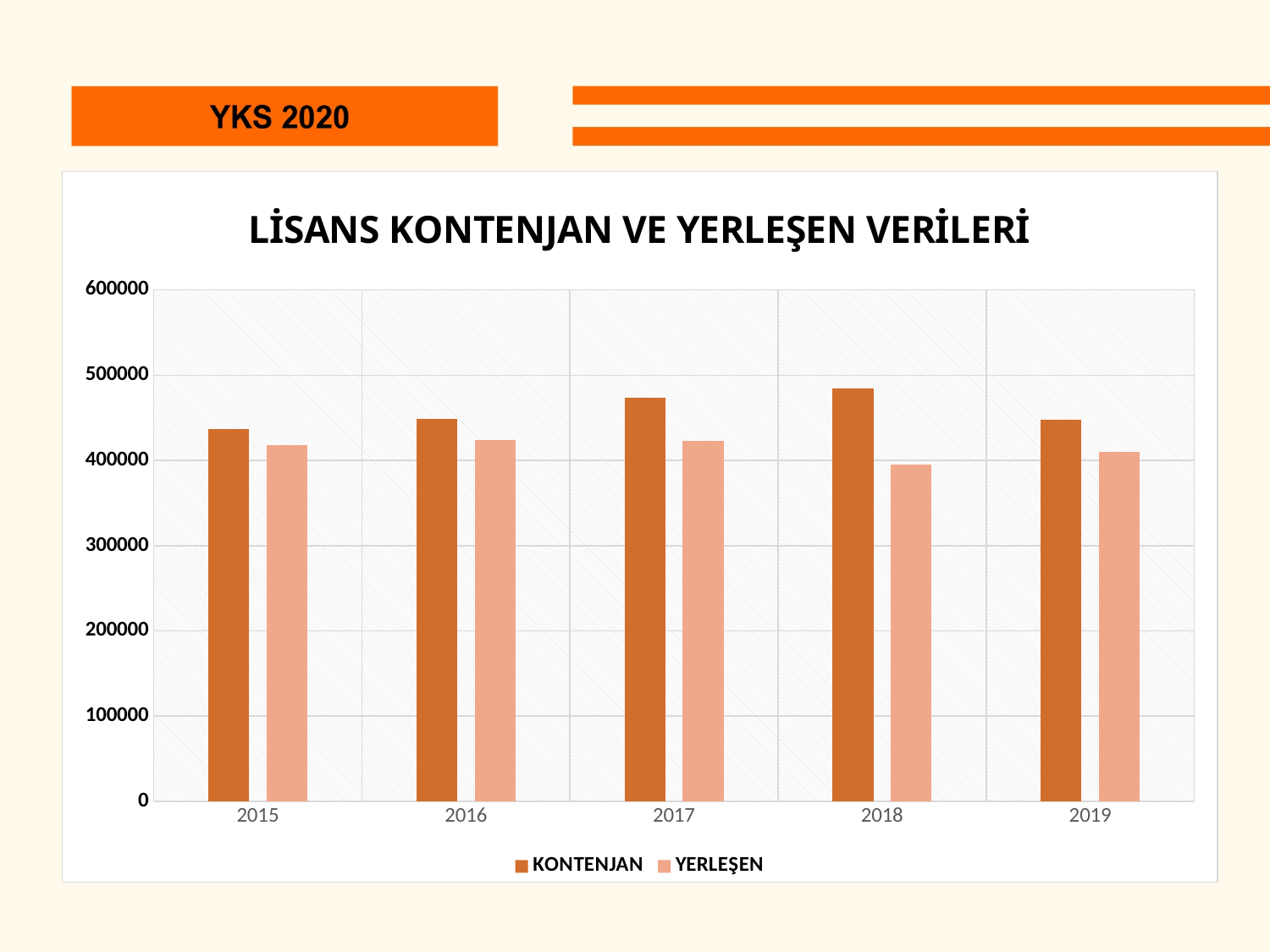
How many series does the legend list? 2 In 2018, which is larger, KONTENJAN or YERLEŞEN? KONTENJAN What is the title of the chart? LİSANS KONTENJAN VE YERLEŞEN VERİLERİ Which year has the highest KONTENJAN value? 2018 Which year has the lowest YERLEŞEN value? 2018 What kind of chart is shown on the slide? bar chart Which is larger, the YERLEŞEN value for 2016 or for 2018? 2016 Does the KONTENJAN value rise or fall from 2015 to 2018? rise Is the YERLEŞEN value for 2015 greater or less than 400000? greater How many years are shown on the x axis? 5 Is the KONTENJAN value for 2017 greater or less than 500000? less